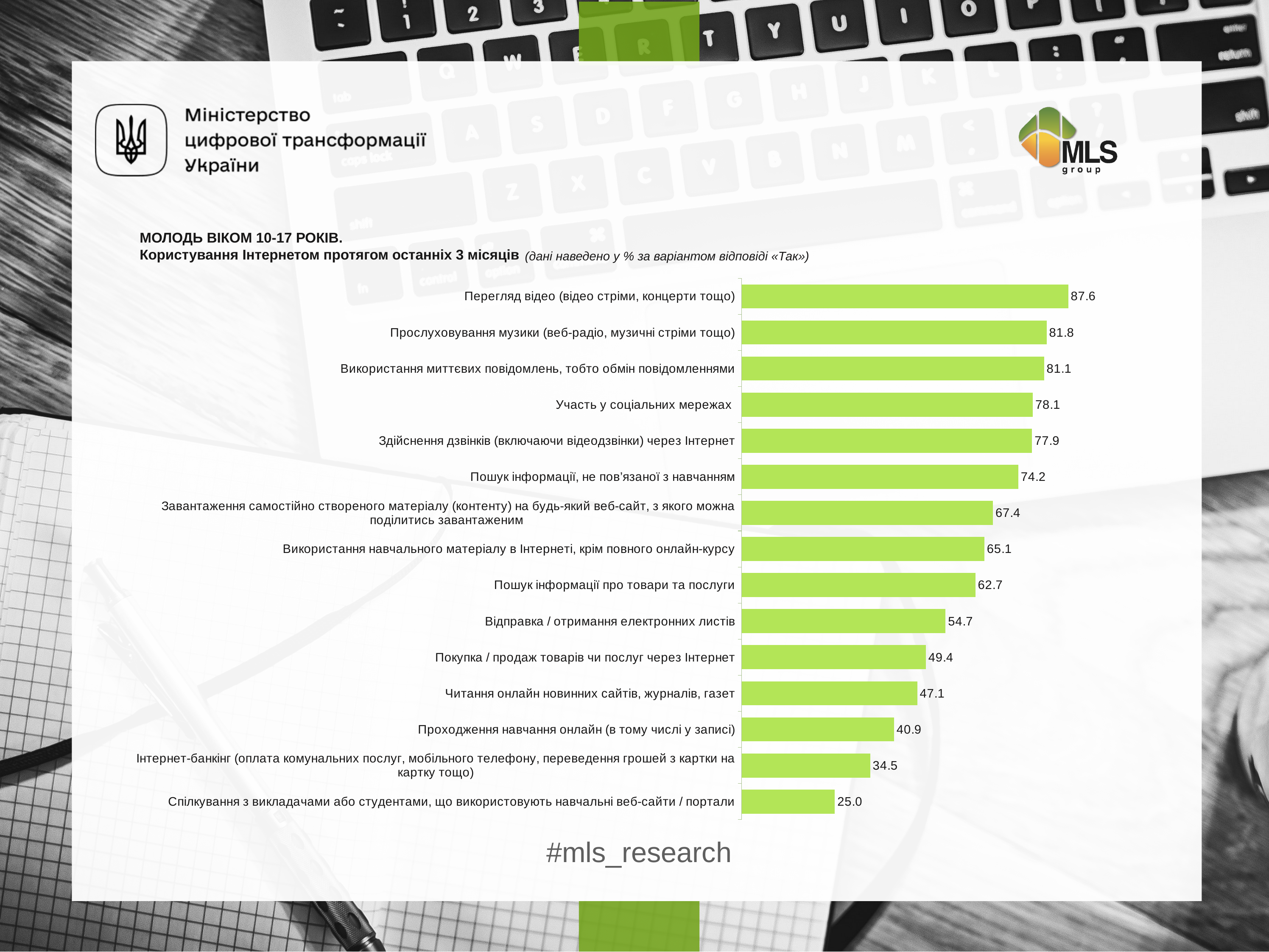
What is the value for "Відправка / отримання електронних листів"? 54.7 Which activity has the lowest value in the chart? Спілкування з викладачами або студентами, що використовують навчальні веб-сайти / портали Which is larger: the value for "Пошук інформації про товари та послуги" or the value for "Читання онлайн новинних сайтів, журналів, газет"? Пошук інформації про товари та послуги What is the difference between "Відправка / отримання електронних листів" and "Покупка / продаж товарів чи послуг через Інтернет"? 5.3 What is the value for "Участь у соціальних мережах"? 78.1 What kind of chart is shown on the slide? Bar chart What is the difference between the highest value (87.6) and the lowest value (25.0) in the chart? 62.6 What colour are the bars in the chart? Green What is the value for "Проходження навчання онлайн (в тому числі у записі)"? 40.9 What is the value for "Перегляд відео (відео стріми, концерти тощо)"? 87.6 How many categories (activities) are plotted in the chart? 15 Which activity has the highest value in the chart? Перегляд відео (відео стріми, концерти тощо)